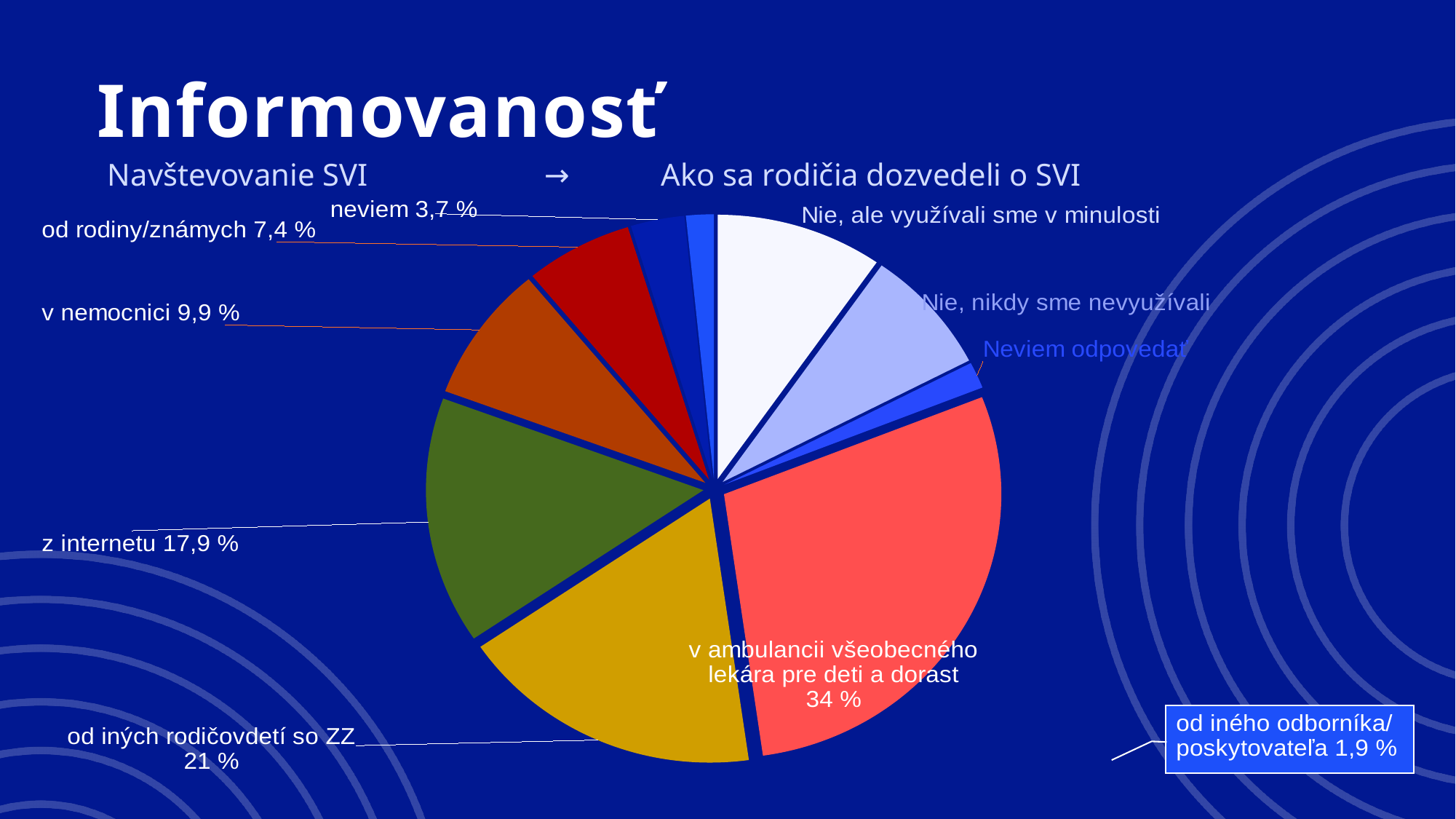
What is the value for 'od iného odborníka/poskytovateľa'? 1,9 % Which labelled source of information has the largest share? v ambulancii všeobecného lekára pre deti a dorast What is the value for 'od iných rodičov detí so ZZ'? 21 % What is the value for 'z internetu'? 17,9 % How many slices does the pie chart have? 10 What is the value for 'od rodiny/známych'? 7,4 % What is the difference between the shares for 'v ambulancii všeobecného lekára pre deti a dorast' and 'od iných rodičov detí so ZZ'? 13 percentage points What is the value for 'v nemocnici'? 9,9 % What share of parents learned about SVI 'v ambulancii všeobecného lekára pre deti a dorast'? 34 % Which is larger: the share for 'z internetu' or for 'v nemocnici'? z internetu Which labelled source of information has the smallest share? od iného odborníka/poskytovateľa What kind of chart is shown on the slide? pie chart